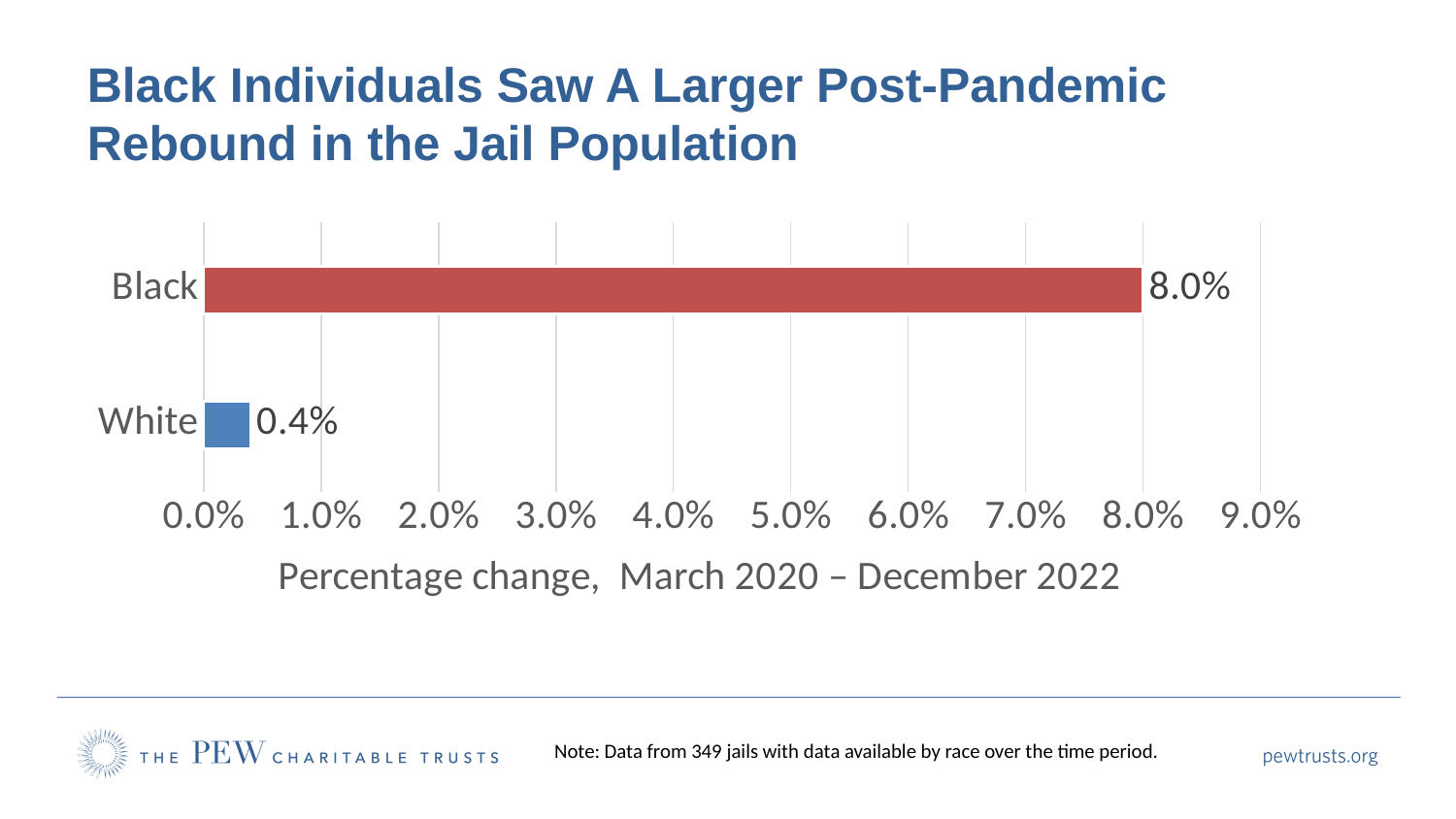
What is the difference between the percentage change for Black and White individuals? 7.6% How many categories are shown in the chart? 2 Is the value for White greater or less than 1.0%? less What kind of chart is shown on the slide? Bar chart Which category has the highest percentage change? Black What is the title of the chart? Black Individuals Saw A Larger Post-Pandemic Rebound in the Jail Population What is the percentage change for White individuals? 0.4% Which category has the lowest percentage change? White What is the label of the x axis? Percentage change, March 2020 – December 2022 Which is larger, the percentage change for Black or for White individuals? Black What is the percentage change for Black individuals? 8.0% Is the value for Black greater or less than 5.0%? greater